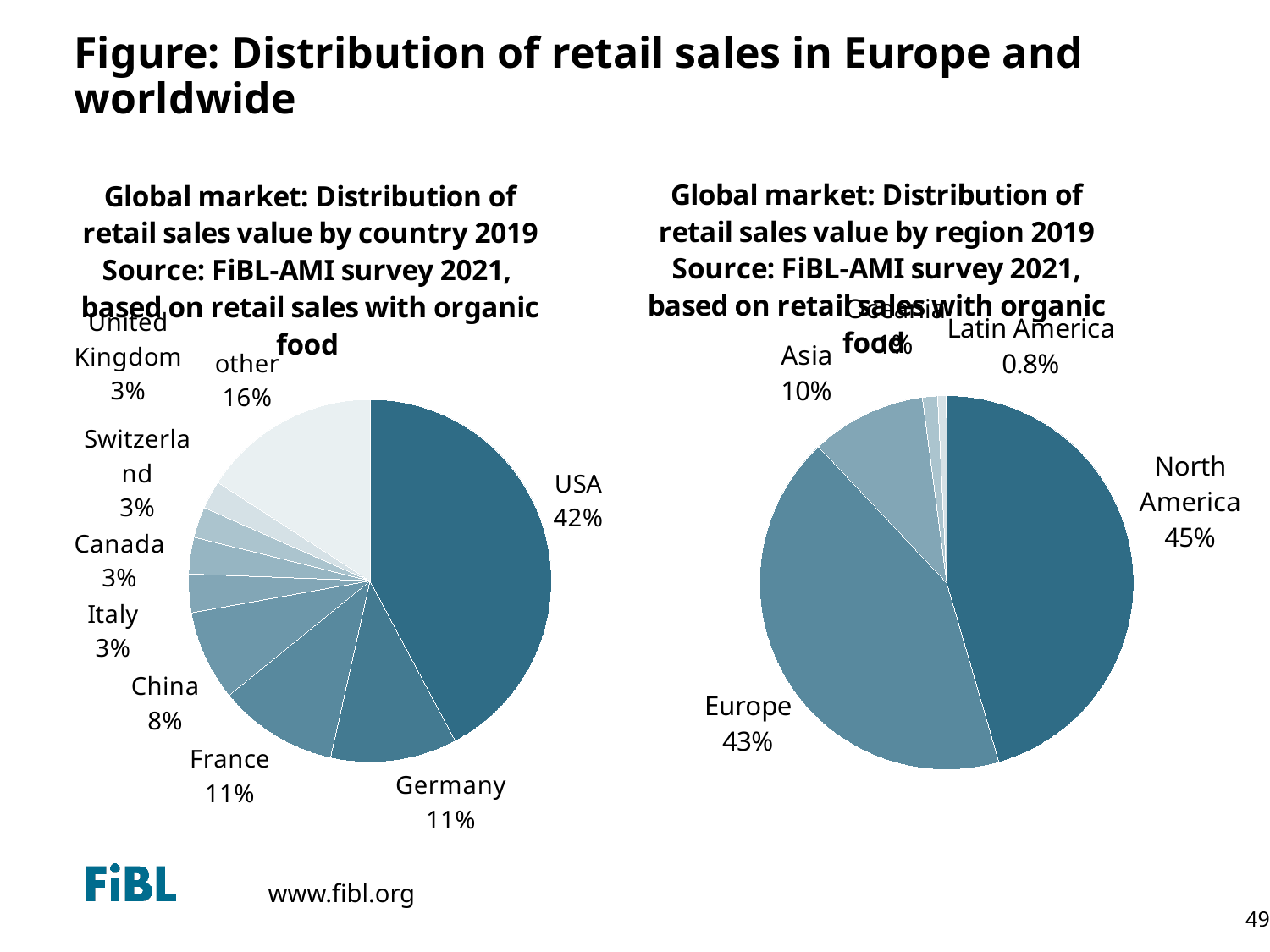
In the left pie chart (distribution by country 2019), which has the larger share, France or China? France In the right pie chart (distribution by region 2019), which region has the largest share? North America In the left pie chart (distribution by country 2019), what share does China have? 8% How many slices does the left pie chart (distribution by country 2019) have? 9 What type of chart is used on this slide to show the distribution of retail sales value? Pie chart In the right pie chart (distribution by region 2019), what share does Europe have? 43% In the left pie chart (distribution by country 2019), which country has the largest share? USA In the right pie chart (distribution by region 2019), what share does Latin America have? 0.8% In the left pie chart (distribution by country 2019), how many percentage points larger is the USA's share than China's? 34 percentage points In the left pie chart (distribution by country 2019), what share of retail sales value does the USA have? 42% In the left pie chart (distribution by country 2019), what share does Germany have? 11%